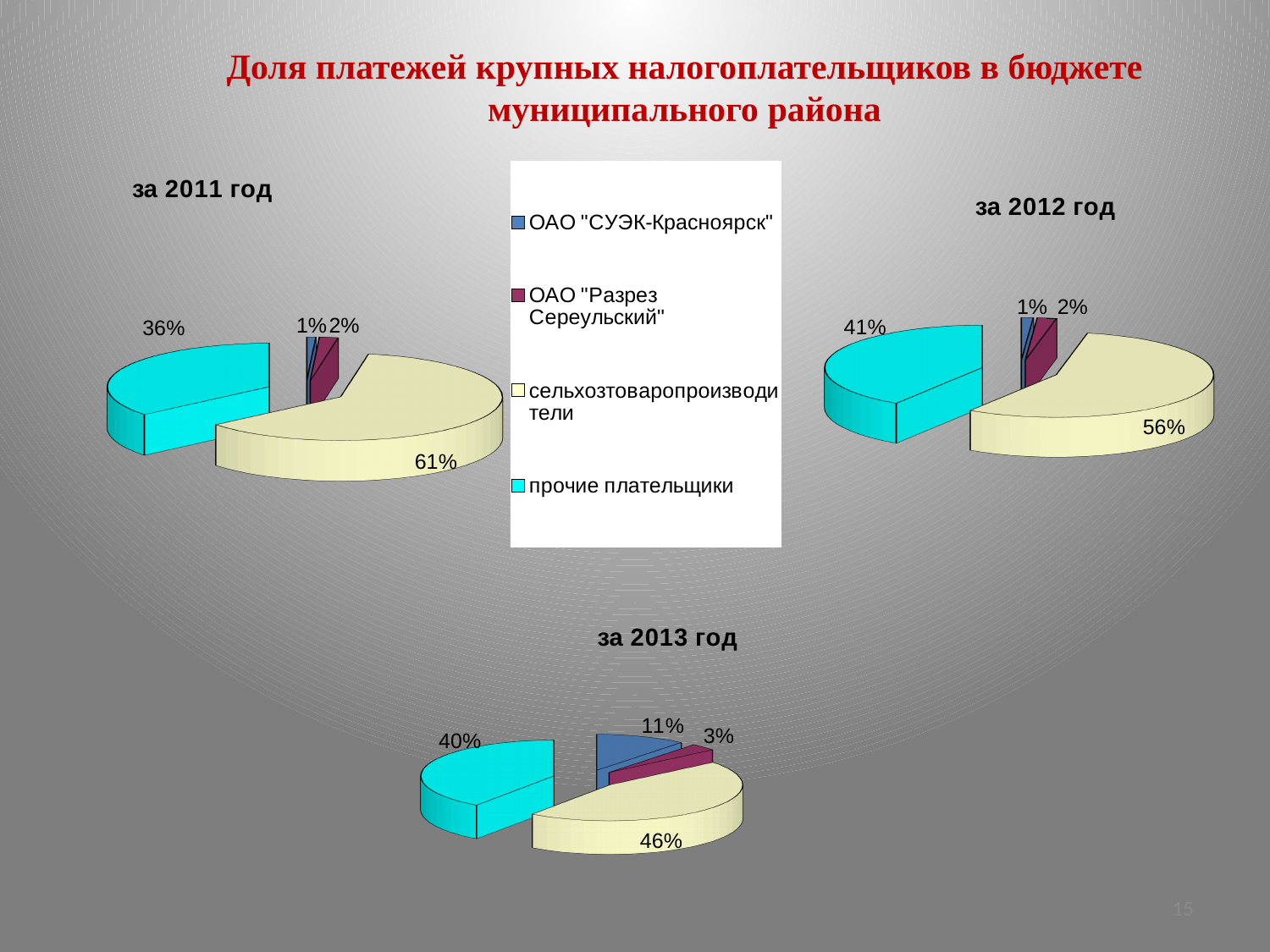
In the chart for 2011 (за 2011 год), which category has the smallest share? ОАО "СУЭК-Красноярск" In the chart for 2013 (за 2013 год), what is the difference between the shares of сельхозтоваропроизводители and прочие плательщики? 6% In the chart for 2013 (за 2013 год), which category has the largest share? сельхозтоваропроизводители In the chart for 2012 (за 2012 год), what share do прочие плательщики have? 41% In the chart for 2013 (за 2013 год), what share does ОАО "Разрез Сереульский" have? 3% In the chart for 2011 (за 2011 год), what share do прочие плательщики have? 36% How many series does the legend list? 4 In the chart for 2011 (за 2011 год), what share do сельхозтоваропроизводители have? 61% In the chart for 2013 (за 2013 год), what share does ОАО "СУЭК-Красноярск" have? 11% Which is larger: the share of прочие плательщики in 2011 or in 2012? 2012 What kind of chart is used for each year on this slide? Pie chart In the chart for 2012 (за 2012 год), what share do сельхозтоваропроизводители have? 56%